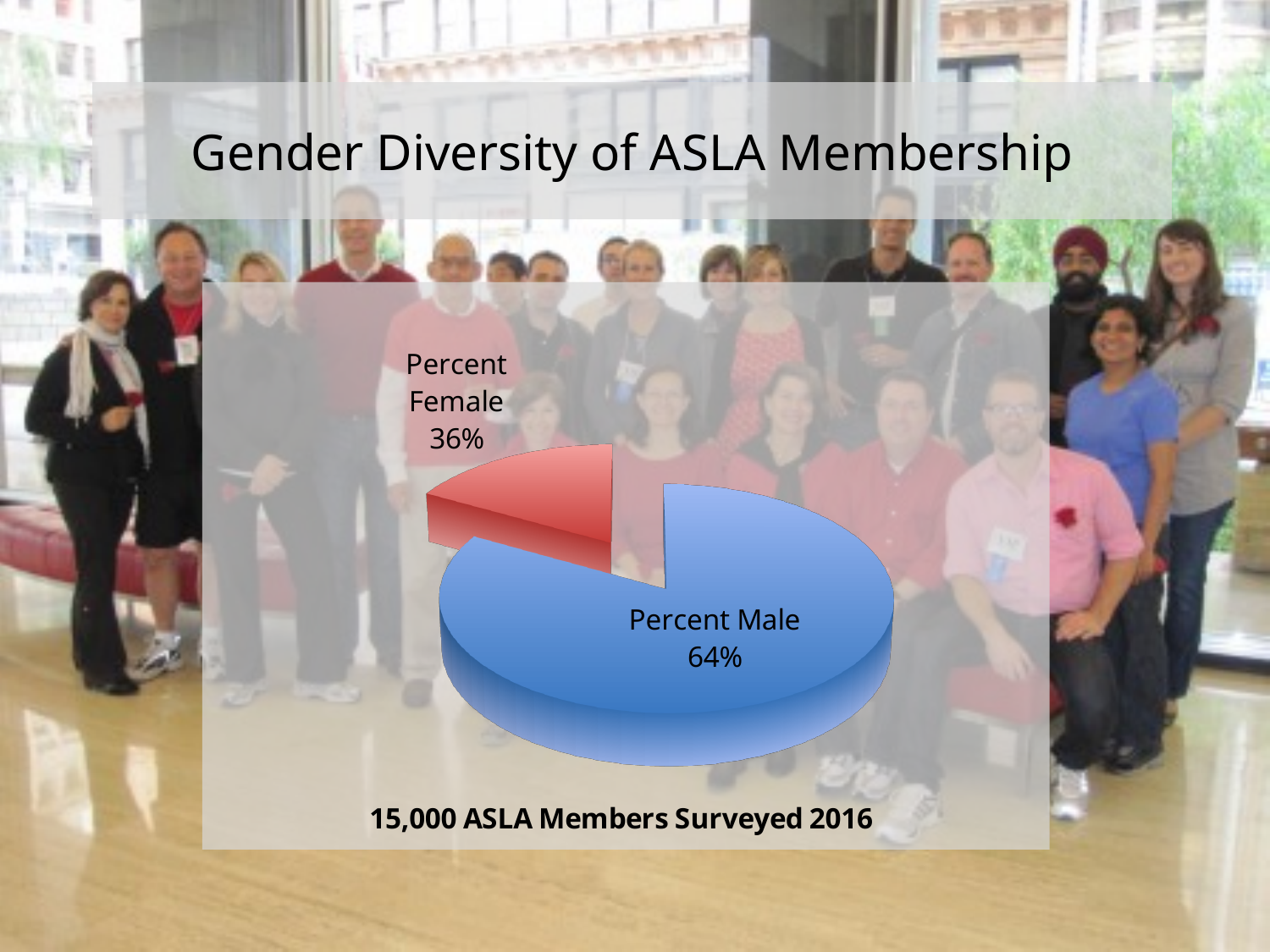
What is the title of the slide containing the chart? Gender Diversity of ASLA Membership What is the value for Percent Female? 36% What colour is the Percent Male slice? blue How many slices does the pie chart have? 2 Which slice is the smallest? Percent Female What kind of chart is shown on the slide? pie chart What is the difference between Percent Male and Percent Female? 28% Which is larger, Percent Male or Percent Female? Percent Male Which slice is the largest? Percent Male What share of the pie does the Percent Female slice represent? 36% What is the value for Percent Male? 64%